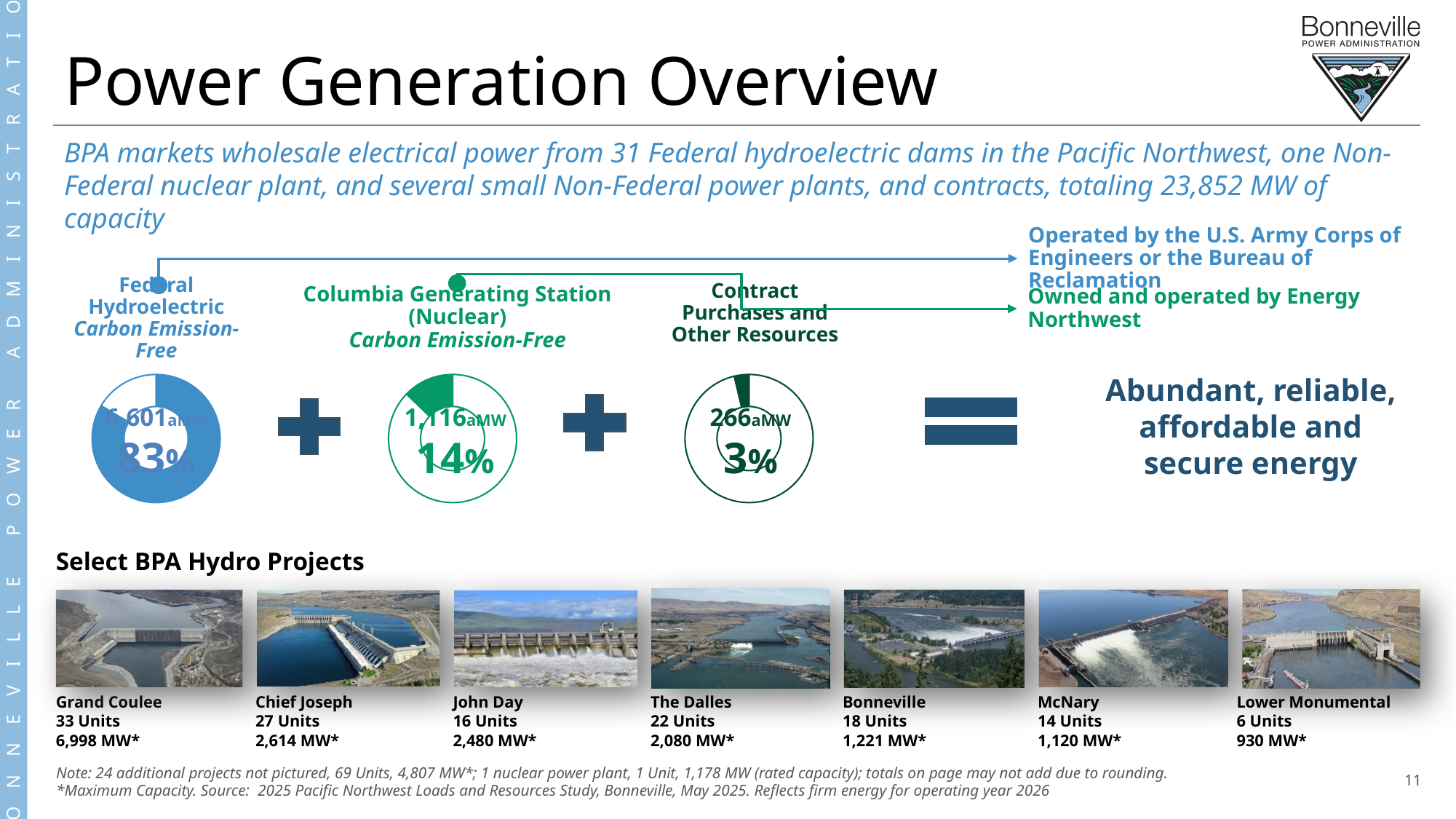
In the Federal Hydroelectric chart, what aMW value is shown? 6,601 aMW Across the three pie charts, which source has the largest share? Federal Hydroelectric In the Contract Purchases and Other Resources chart, what aMW value is shown? 266 aMW Which is larger: the aMW value in the Columbia Generating Station chart or the aMW value in the Contract Purchases and Other Resources chart? Columbia Generating Station In the Columbia Generating Station (Nuclear) chart, what aMW value is shown? 1,116 aMW In the Columbia Generating Station (Nuclear) chart, what percentage share is shown? 14% In the Federal Hydroelectric chart, what percentage share is shown? 83% How many pie charts are shown in the power source row on the slide? 3 What kind of chart is used to show the Federal Hydroelectric share? Doughnut chart In the Contract Purchases and Other Resources chart, what percentage share is shown? 3% Across the three pie charts, which source has the smallest share? Contract Purchases and Other Resources What is the difference in percentage share between the Federal Hydroelectric chart and the Columbia Generating Station chart? 69%